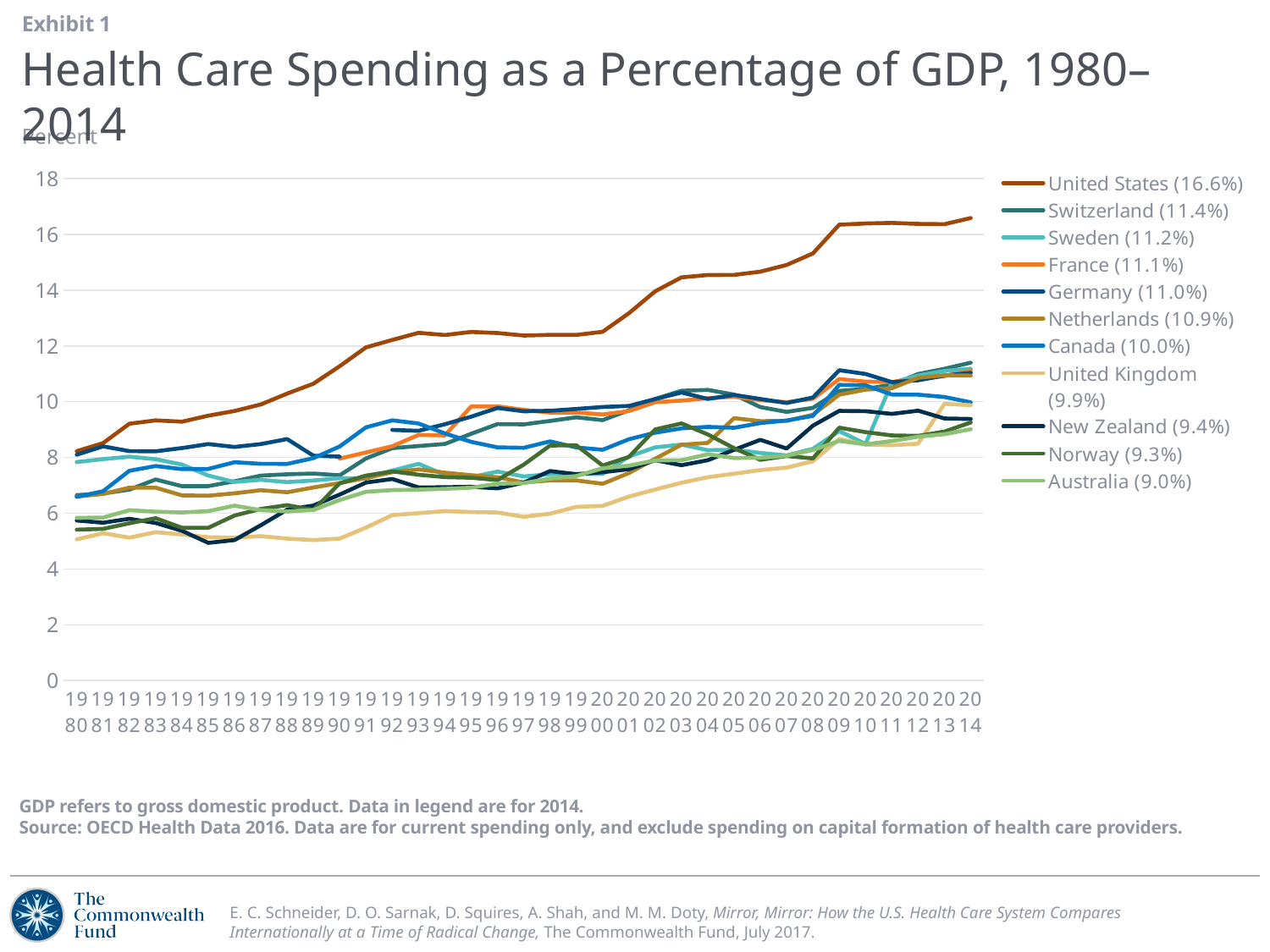
According to the legend, what was Australia's health care spending as a percentage of GDP in 2014? 9.0% According to the legend, what was health care spending as a percentage of GDP in the United States in 2014? 16.6% How many series does the legend list? 11 Does the United States line generally rise or fall from 1980 to 2014? rise What is the difference between the 2014 values for the United States and Switzerland shown in the legend? 5.2 percentage points What is the title of the chart? Health Care Spending as a Percentage of GDP, 1980–2014 What kind of chart is shown on the slide? line chart Which country had the highest health care spending as a percentage of GDP in 2014? United States Which country had the lowest health care spending as a percentage of GDP in 2014? Australia Which had a higher 2014 value, Canada or the United Kingdom? Canada According to the legend, what was Switzerland's health care spending as a percentage of GDP in 2014? 11.4% Is the value for the United States in 1980 greater or less than 10? less